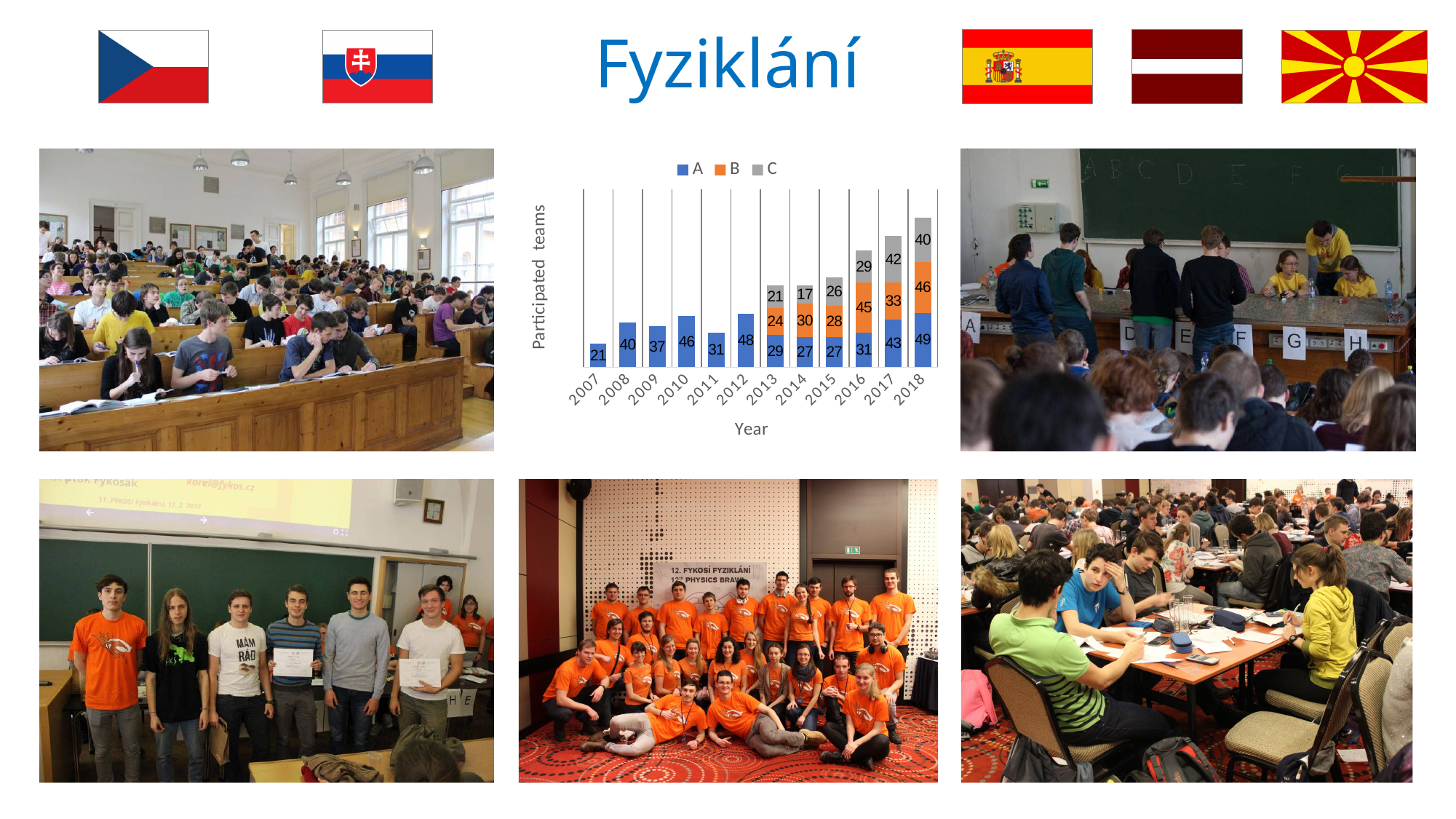
What is the value of series A in 2007? 21 What is the value of series C in 2017? 42 Which year has the highest value for series A? 2018 What is the total number of participated teams in 2015? 81 How many years are shown on the x axis? 12 What is the value of series B in 2016? 45 How many series does the legend list? 3 Which is larger, series A in 2012 or series A in 2011? 2012 What is the total number of participated teams in 2018? 135 What is the difference between the series B values in 2018 and 2017? 13 Which year has the lowest value for series A? 2007 What kind of chart is shown on the slide? stacked bar chart